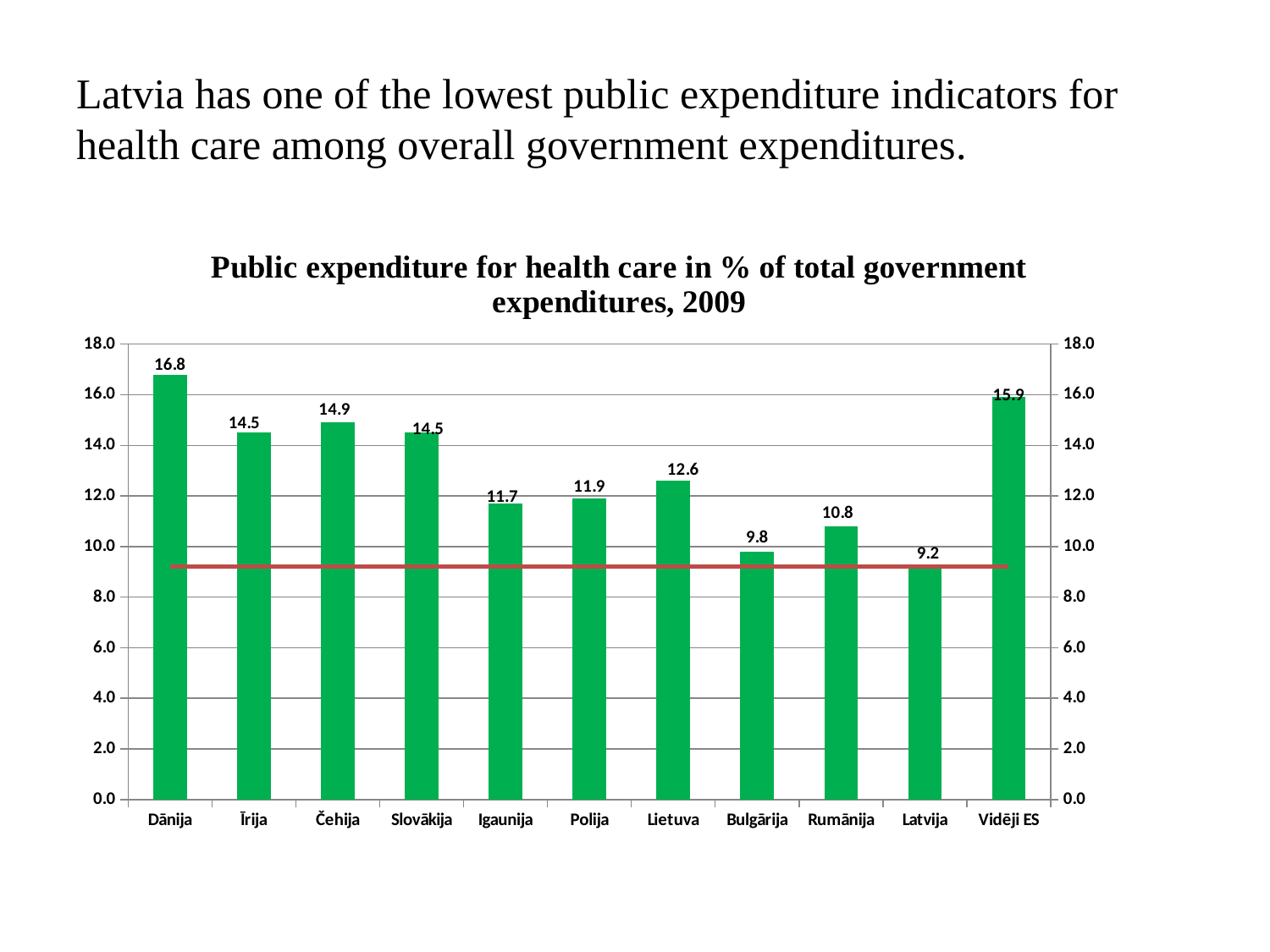
What is the title of the chart? Public expenditure for health care in % of total government expenditures, 2009 How many categories are shown on the x axis? 11 What is the value for Dānija? 16.8 What kind of chart is shown on the slide? bar chart Is the value for Bulgārija greater or less than 10.0? less What is the value for Latvija? 9.2 Which category has the highest value? Dānija Which is larger, the value for Lietuva or the value for Igaunija? Lietuva Which category has the lowest value? Latvija What is the difference between the values for Vidēji ES and Latvija? 6.7 What is the value for Vidēji ES? 15.9 What is the difference between the values for Dānija and Latvija? 7.6